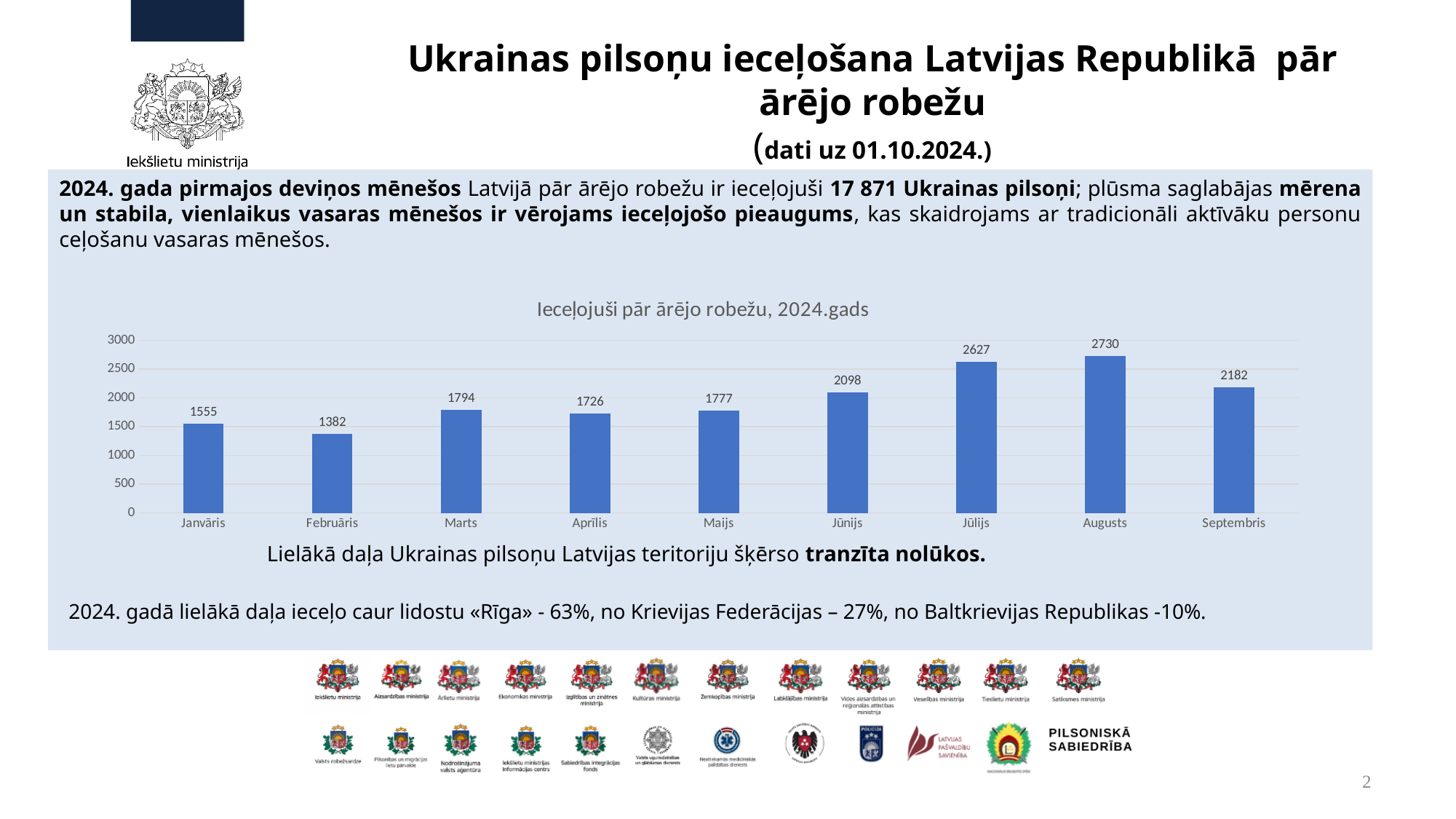
What is the value for Septembris? 2182 Is the value for Jūnijs greater or less than 2000? greater What kind of chart is shown on the slide? bar chart Which is larger, the value for Marts or the value for Aprīlis? Marts Which month has the lowest value? Februāris Which month has the highest value? Augusts What is the value for Janvāris? 1555 What is the difference between the values for Augusts and Janvāris? 1175 How many months are shown on the x axis? 9 Do the values rise or fall from Maijs to Augusts? rise What is the value for Jūlijs? 2627 What is the title of the chart? Ieceļojuši pār ārējo robežu, 2024.gads